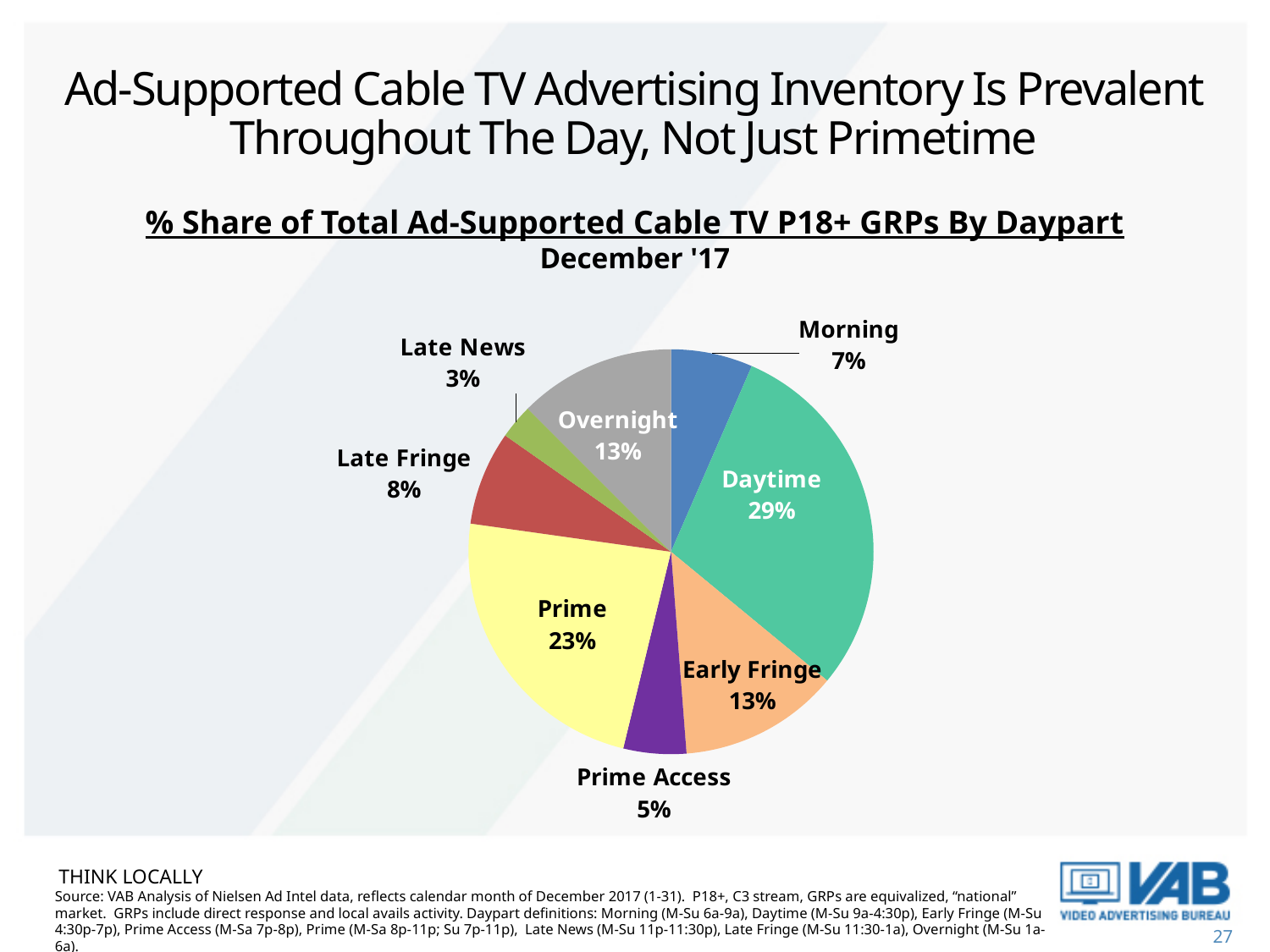
What is the combined share of Prime and Prime Access? 28% Which month does the chart's data reflect? December '17 How many dayparts (slices) are shown in the pie chart? 8 Which daypart has the largest share of the pie? Daytime What is the share for Prime? 23% Which daypart has the smallest share of the pie? Late News What is the share for Overnight? 13% What kind of chart is shown on the slide? pie chart What is the difference in share between Daytime and Prime? 6 percentage points What share of total ad-supported cable TV P18+ GRPs does Daytime account for? 29% Which has a larger share, Late Fringe or Morning? Late Fringe What is the share for Late News? 3%